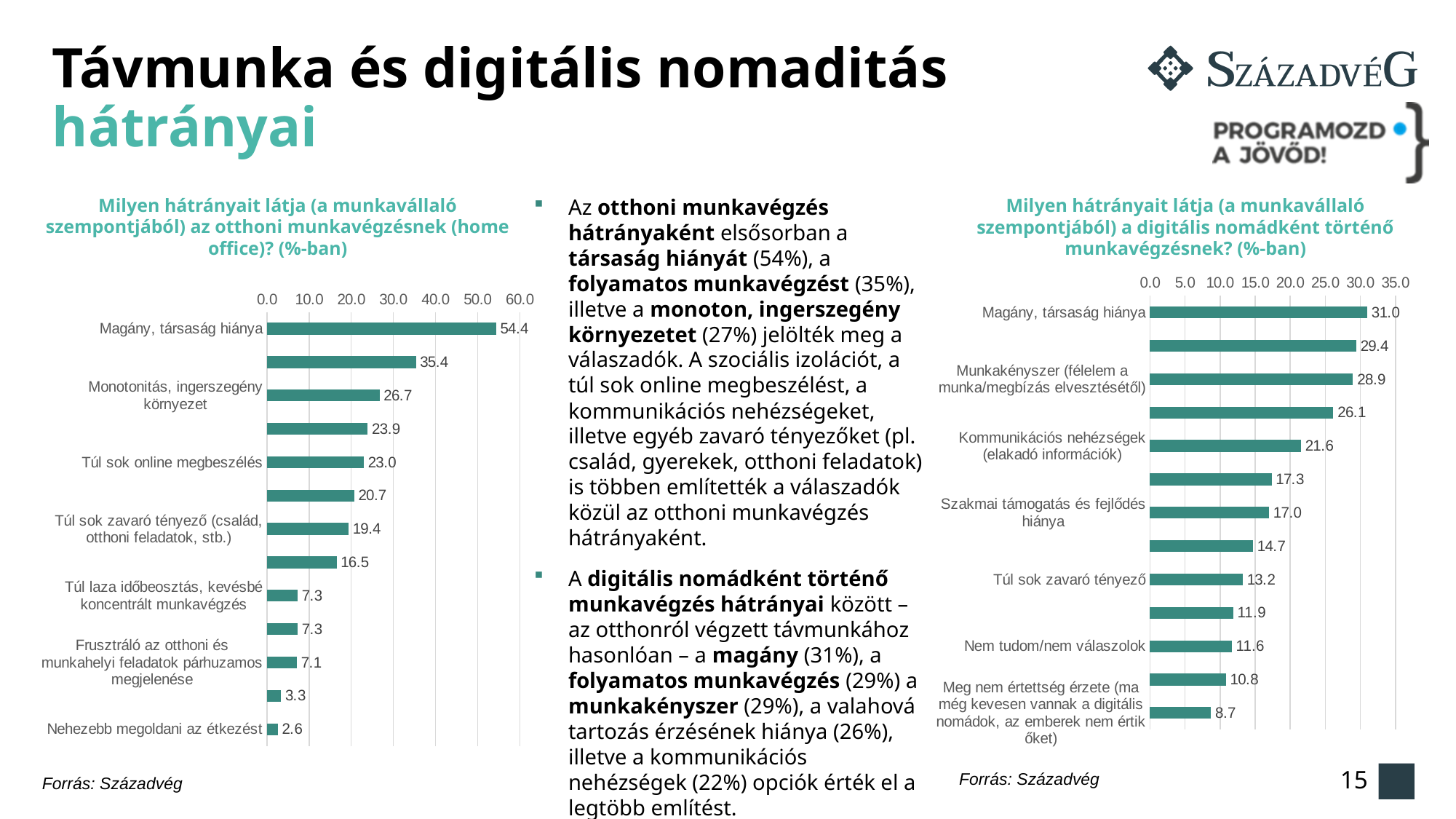
In the left chart (home office disadvantages), what is the value for 'Magány, társaság hiánya'? 54.4 In the left chart (home office disadvantages), how many bars are plotted? 13 In the right chart (digital nomad disadvantages), which is larger: 'Kommunikációs nehézségek (elakadó információk)' or 'Szakmai támogatás és fejlődés hiánya'? Kommunikációs nehézségek (elakadó információk) In the left chart (home office disadvantages), which category has the lowest value? Nehezebb megoldani az étkezést In the right chart (digital nomad disadvantages), what is the value for 'Nem tudom/nem válaszolok'? 11.6 What type of chart is the left chart (home office disadvantages)? Bar chart In the right chart (digital nomad disadvantages), what is the value for 'Munkakényszer (félelem a munka/megbízás elvesztésétől)'? 28.9 In the left chart (home office disadvantages), what is the value for 'Túl sok online megbeszélés'? 23.0 In the right chart (digital nomad disadvantages), what is the highest value shown on the x axis? 35.0 In the left chart (home office disadvantages), what is the difference between 'Magány, társaság hiánya' and 'Monotonitás, ingerszegény környezet'? 27.7 In the right chart (digital nomad disadvantages), what is the difference between 'Magány, társaság hiánya' and 'Meg nem értettség érzete'? 22.3 In the right chart (digital nomad disadvantages), which category has the highest value? Magány, társaság hiánya